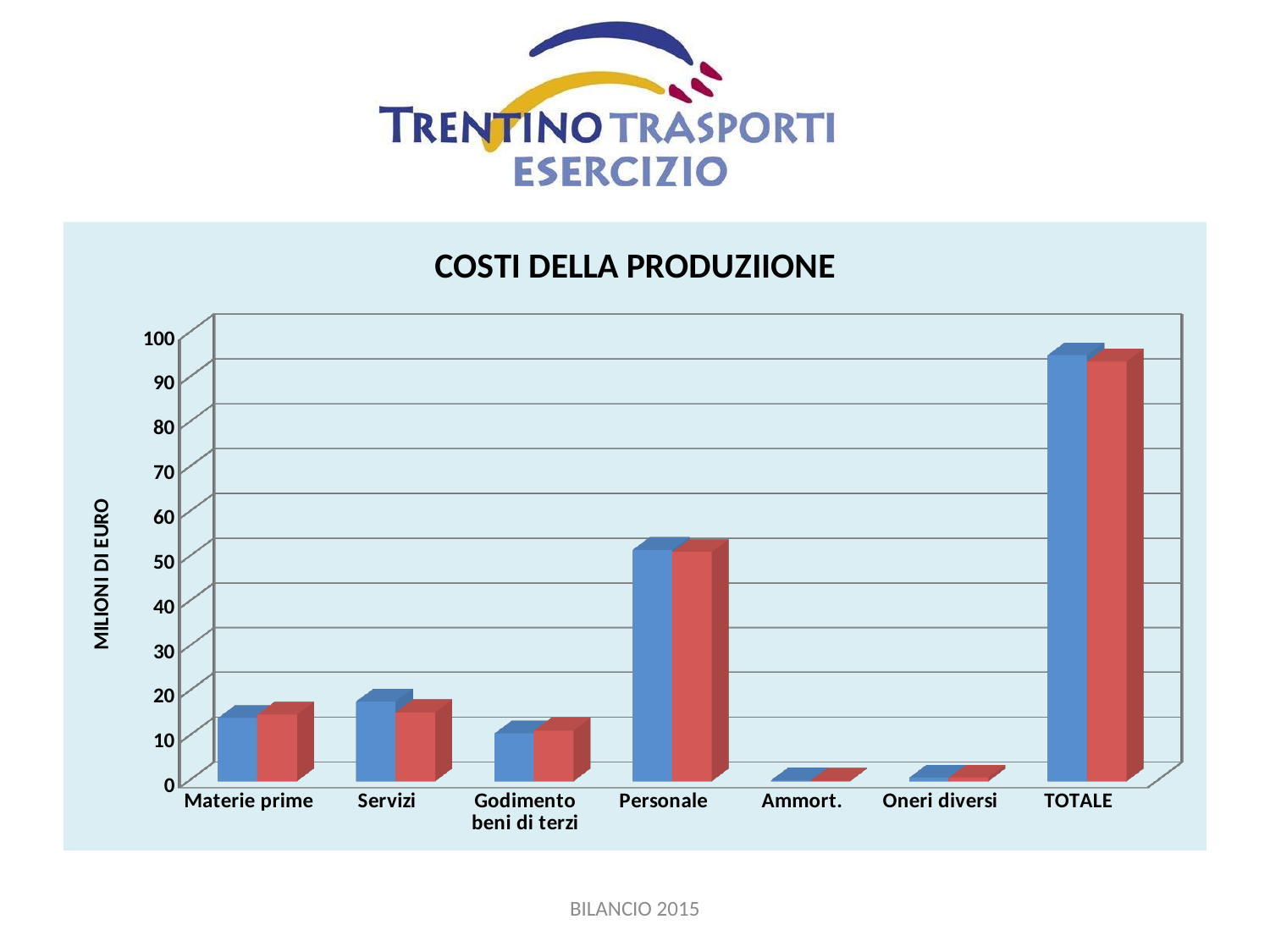
What type of chart is shown on the slide? bar chart How many categories are shown on the x axis? 7 Which has the larger blue bar, Godimento beni di terzi or Oneri diversi? Godimento beni di terzi Which has the larger blue bar, Personale or Servizi? Personale Is the value of the blue bar for Servizi greater or less than 10? greater Which category has the highest bars? TOTALE Is the value of the blue bar for TOTALE greater or less than 90? greater Is the value of the red bar for Personale greater or less than 40? greater What is the title of the chart? COSTI DELLA PRODUZIIONE What is the label of the vertical axis? MILIONI DI EURO